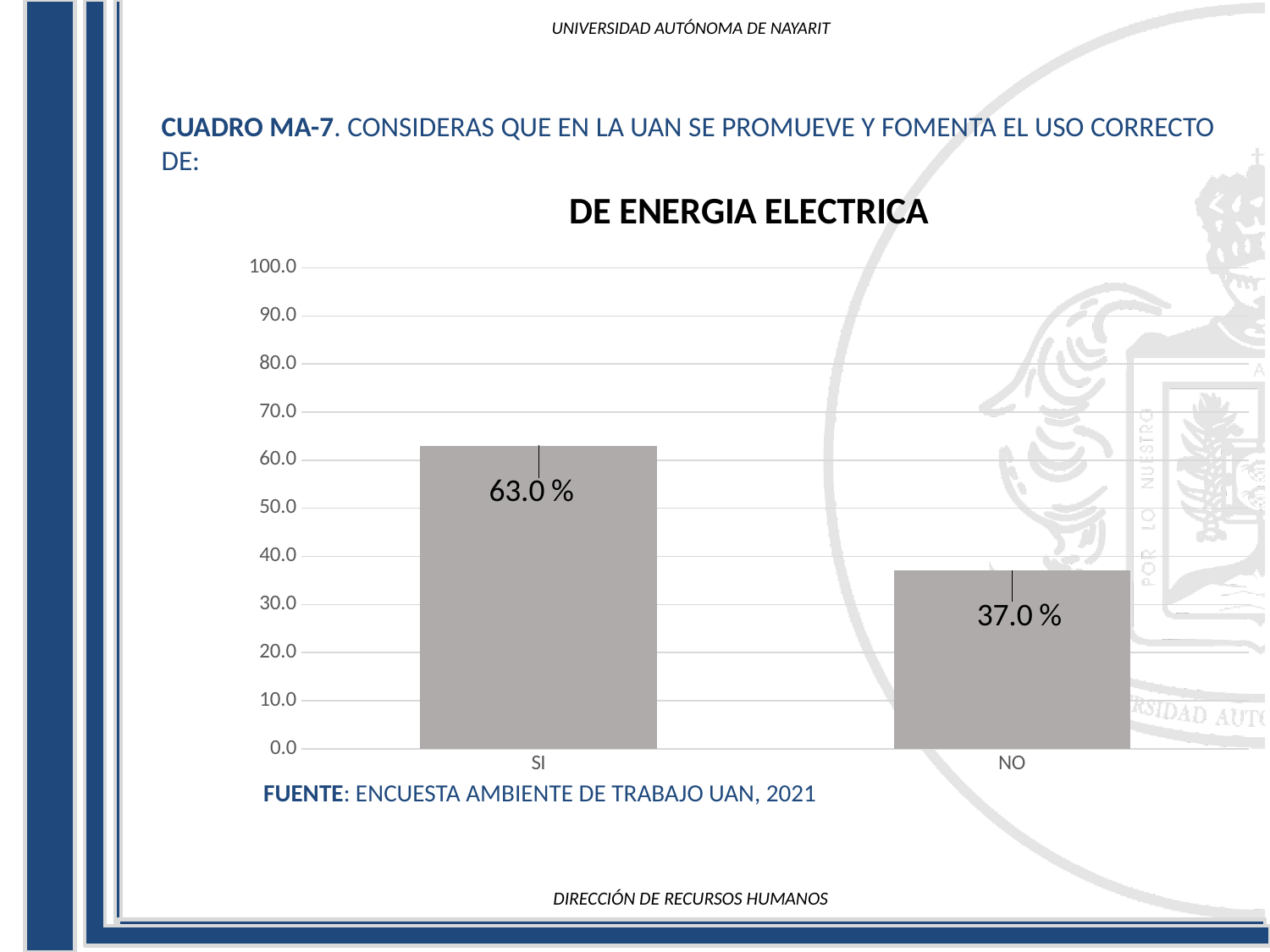
What is the highest value shown on the y axis? 100.0 What is the difference between the values for SI and NO? 26.0 % What kind of chart is shown? bar chart What is the title of the chart? DE ENERGIA ELECTRICA What is the value for NO? 37.0 % Is the value for SI greater or less than 60.0? greater Which category has the lowest value? NO Is the value for NO greater or less than 40.0? less What is the value for SI? 63.0 % Which is larger, the value for SI or the value for NO? SI Which category has the highest value? SI How many categories are shown on the x axis? 2